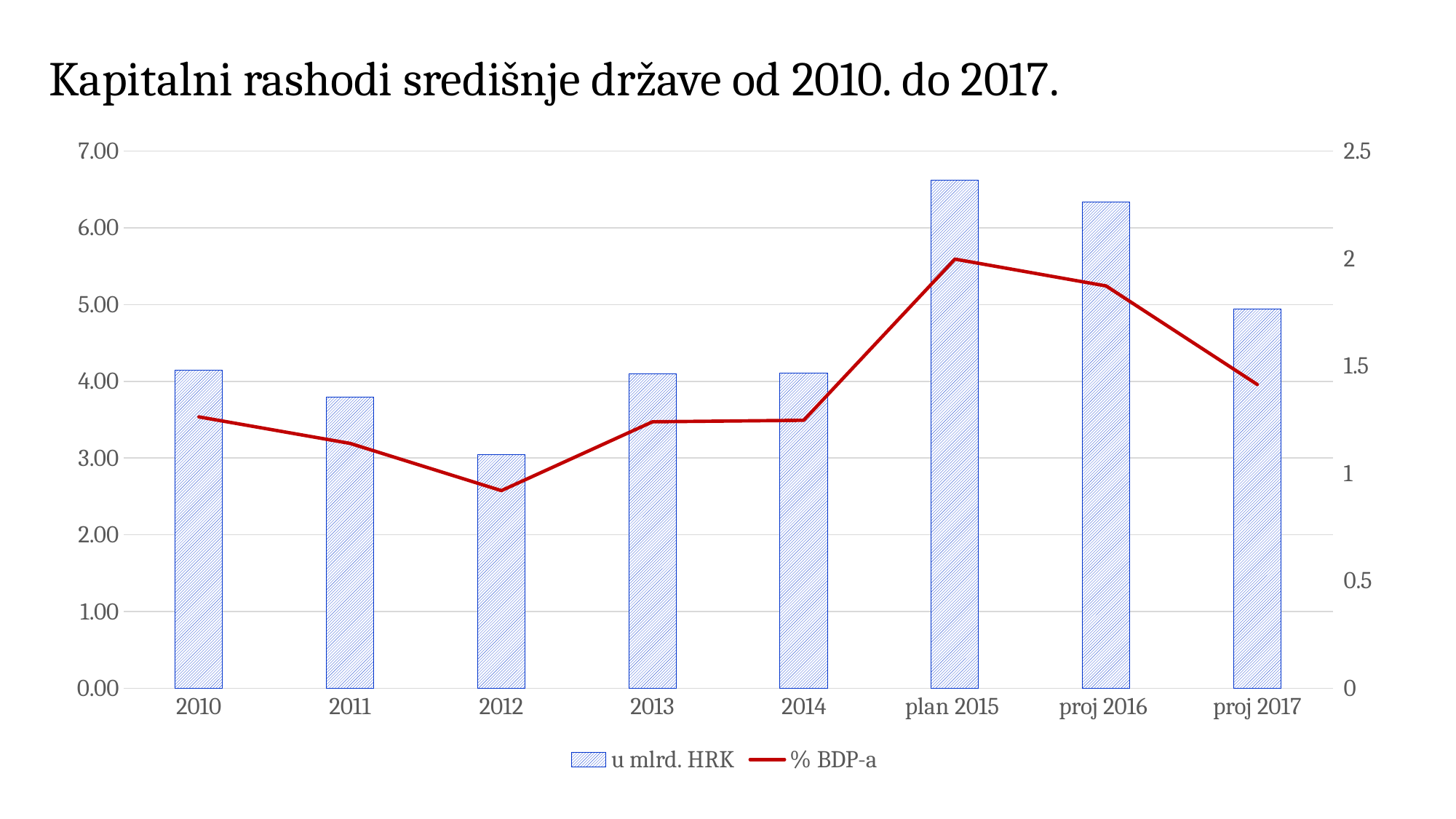
What kind of chart is shown on the slide? A combined bar and line chart In which category does the '% BDP-a' line reach its lowest point? 2012 Is the '% BDP-a' value for proj 2017 greater or less than 1.5? less Is the 'u mlrd. HRK' bar for 2011 greater or less than 4.00? less Do the 'u mlrd. HRK' bars rise or fall from 2010 to 2012? fall Which has the larger 'u mlrd. HRK' bar, plan 2015 or proj 2016? plan 2015 How many series does the legend list? 2 How many categories are shown on the x axis? 8 Which category has the highest bar for 'u mlrd. HRK'? plan 2015 Which category has the lowest bar for 'u mlrd. HRK'? 2012 Is the 'u mlrd. HRK' bar for plan 2015 greater or less than 6.00? greater